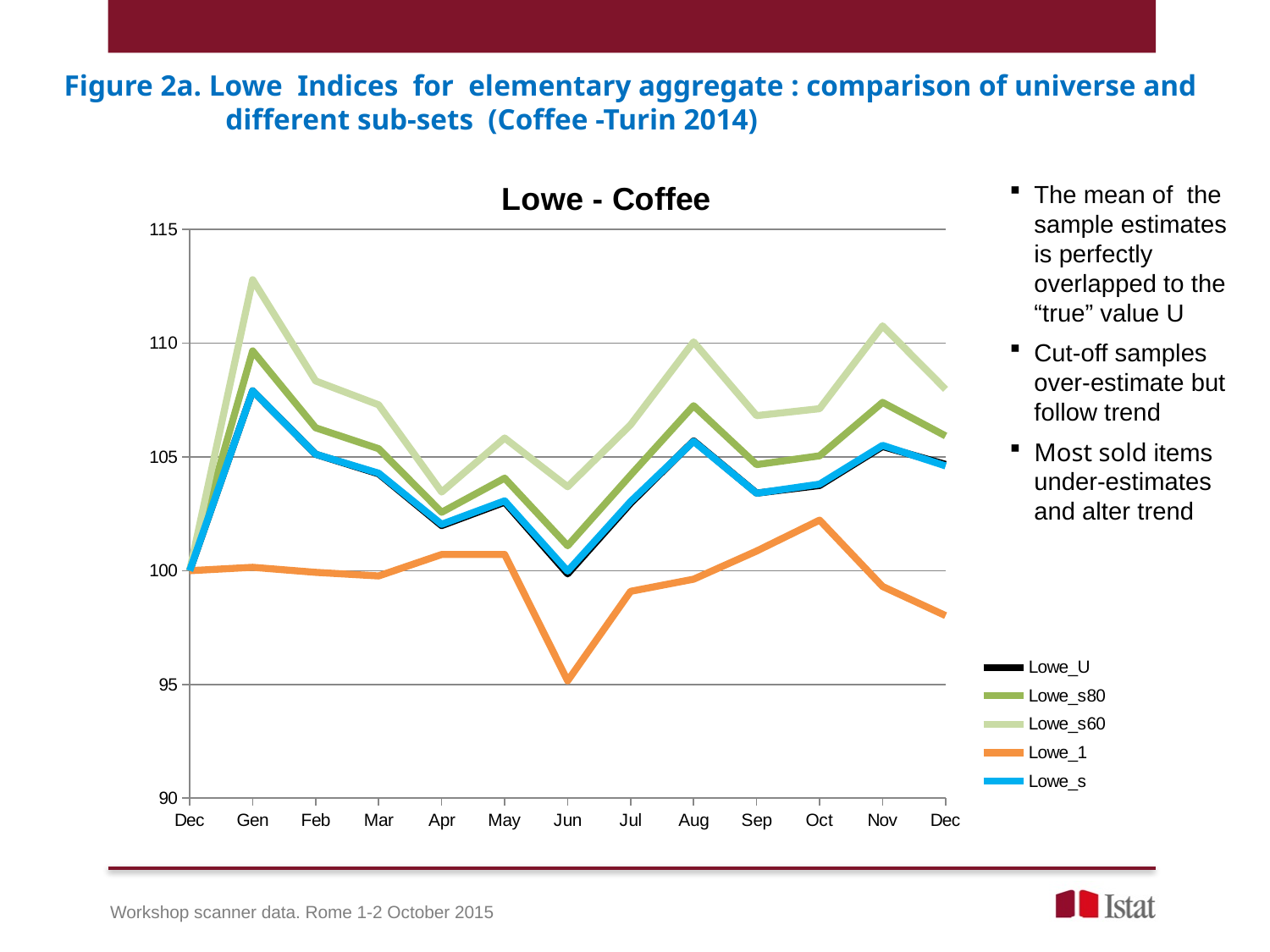
Does the Lowe_1 series rise or fall from Jun to Oct? rise What is the title of the chart? Lowe - Coffee Is the value of Lowe_s60 in Gen greater or less than 110? greater Which series is drawn in orange? Lowe_1 What kind of chart is shown on the slide? line chart Is the value of Lowe_1 in Jun greater or less than 100? less Which is larger in Gen, Lowe_s60 or Lowe_1? Lowe_s60 In which month does the Lowe_1 series reach its lowest value? Jun How many series does the legend list? 5 How many months are plotted along the x axis? 13 Which series has the lowest value in Jun? Lowe_1 In which month does the Lowe_s60 series reach its highest value? Gen